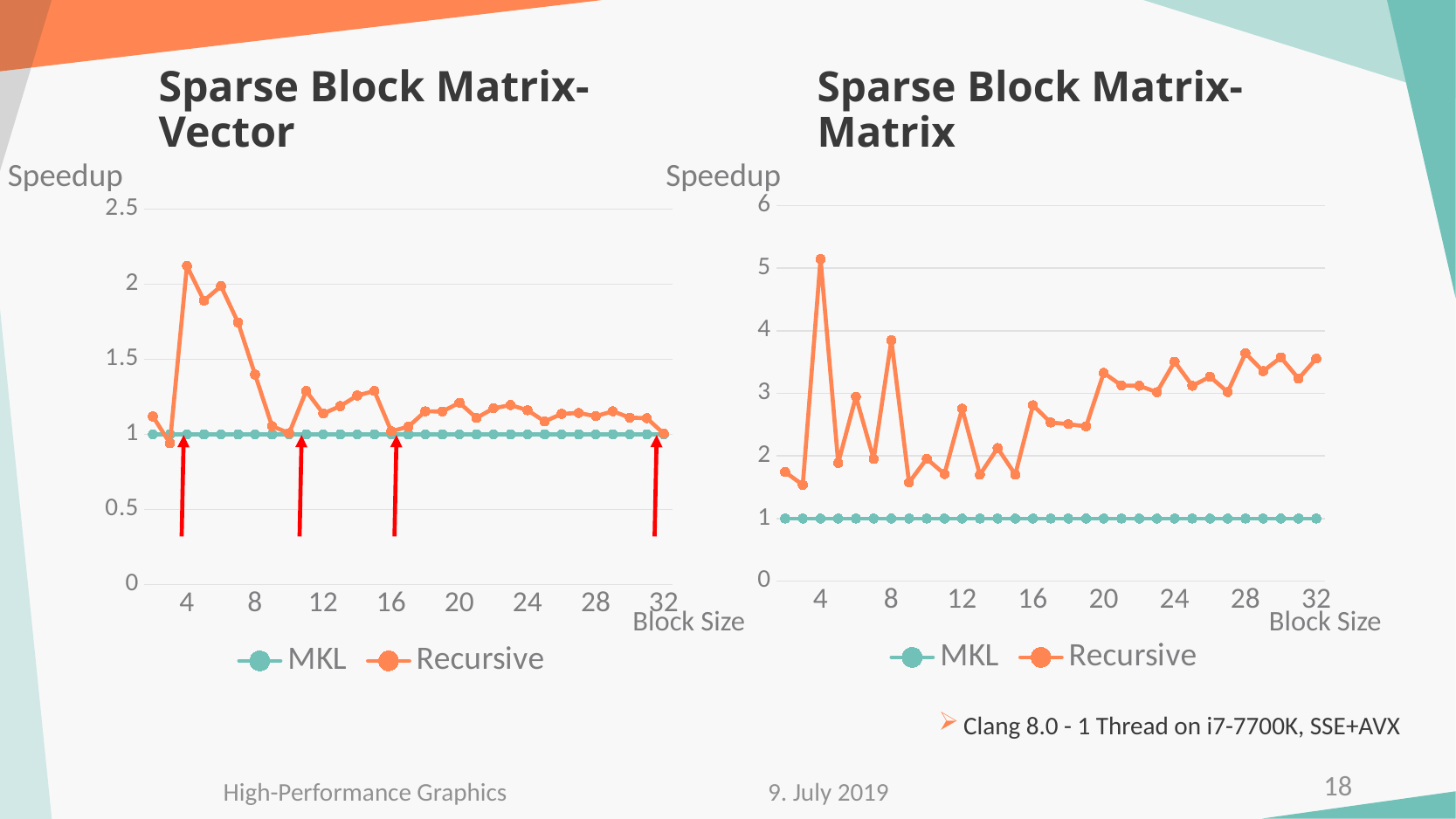
In the Sparse Block Matrix-Vector chart, what is the MKL speedup at block size 16? 1 In the Sparse Block Matrix-Matrix chart, which series is higher at block size 8, MKL or Recursive? Recursive What label is shown on the x axis of the Sparse Block Matrix-Vector chart? Block Size In the Sparse Block Matrix-Matrix chart, is the Recursive speedup at block size 32 greater or less than 3? greater What type of chart is the Sparse Block Matrix-Vector chart? line chart In the Sparse Block Matrix-Matrix chart, at which block size does the Recursive series reach its highest speedup? 4 In the Sparse Block Matrix-Matrix chart, what is the MKL speedup at block size 20? 1 In the Sparse Block Matrix-Matrix chart, is the Recursive speedup at block size 4 greater or less than 4? greater In the Sparse Block Matrix-Vector chart, at which block size does the Recursive series reach its highest speedup? 4 How many series does the legend of the Sparse Block Matrix-Matrix chart list? 2 In the Sparse Block Matrix-Vector chart, is the Recursive speedup at block size 4 greater or less than 2? greater